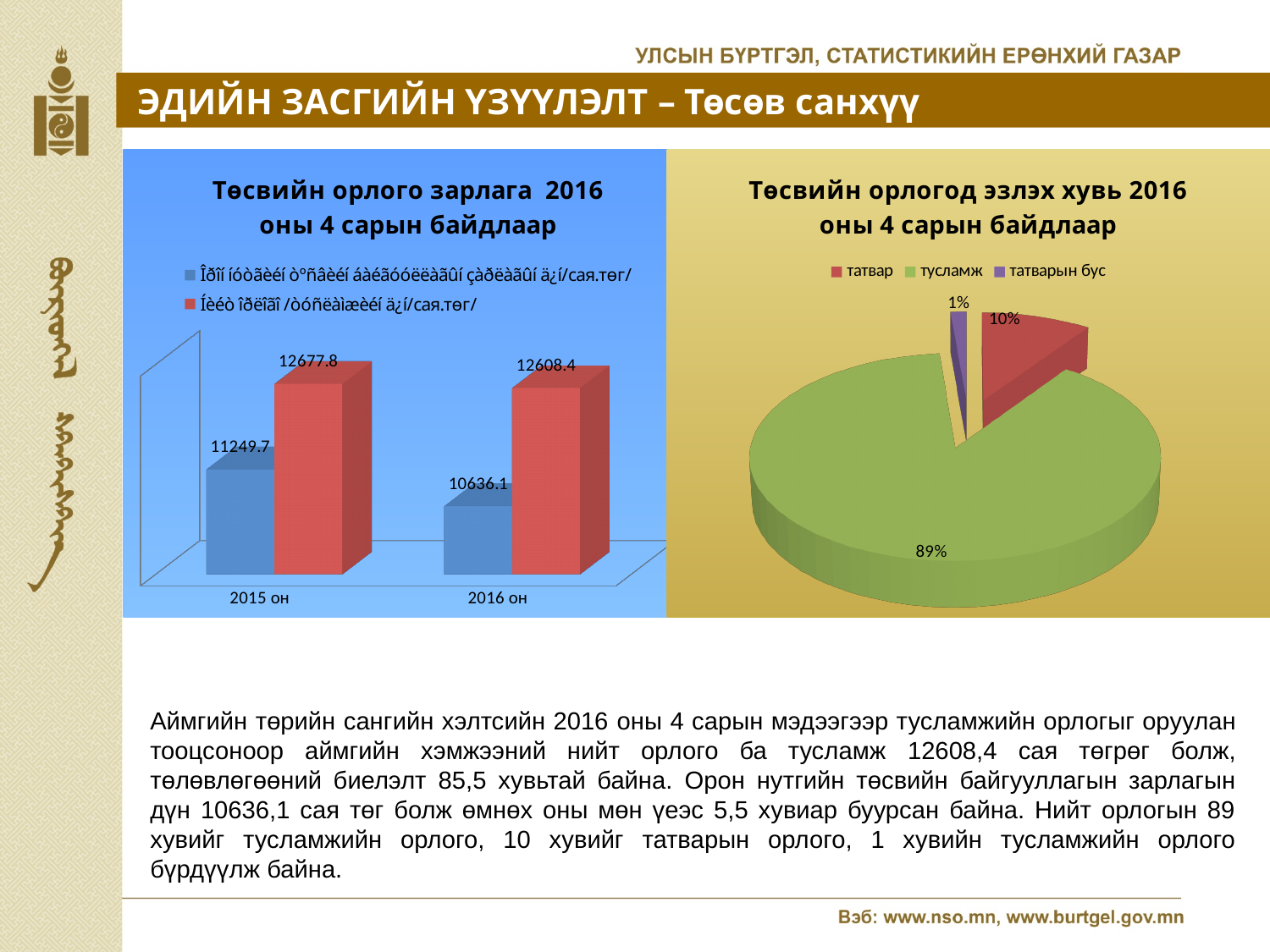
In the bar chart 'Төсвийн орлого зарлага 2016 оны 4 сарын байдлаар', what is the value of the red bar for 2016 он? 12608.4 In the bar chart 'Төсвийн орлого зарлага 2016 оны 4 сарын байдлаар', what is the difference between the red bar and the blue bar for 2016 он? 1972.3 In the bar chart 'Төсвийн орлого зарлага 2016 оны 4 сарын байдлаар', what is the value of the blue bar for 2015 он? 11249.7 What kind of chart is 'Төсвийн орлогод эзлэх хувь 2016 оны 4 сарын байдлаар'? pie chart In the bar chart 'Төсвийн орлого зарлага 2016 оны 4 сарын байдлаар', does the blue series rise or fall from 2015 он to 2016 он? fall In the bar chart 'Төсвийн орлого зарлага 2016 оны 4 сарын байдлаар', which is larger for 2015 он, the blue bar or the red bar? the red bar How many series does the legend of the bar chart 'Төсвийн орлого зарлага 2016 оны 4 сарын байдлаар' list? 2 In the pie chart 'Төсвийн орлогод эзлэх хувь 2016 оны 4 сарын байдлаар', what share does тусламж have? 89% In the bar chart 'Төсвийн орлого зарлага 2016 оны 4 сарын байдлаар', what is the value of the blue bar for 2016 он? 10636.1 In the pie chart 'Төсвийн орлогод эзлэх хувь 2016 оны 4 сарын байдлаар', which category has the smallest share? татварын бус In the pie chart 'Төсвийн орлогод эзлэх хувь 2016 оны 4 сарын байдлаар', what share does татвар have? 10% In the bar chart 'Төсвийн орлого зарлага 2016 оны 4 сарын байдлаар', what is the value of the red bar for 2015 он? 12677.8